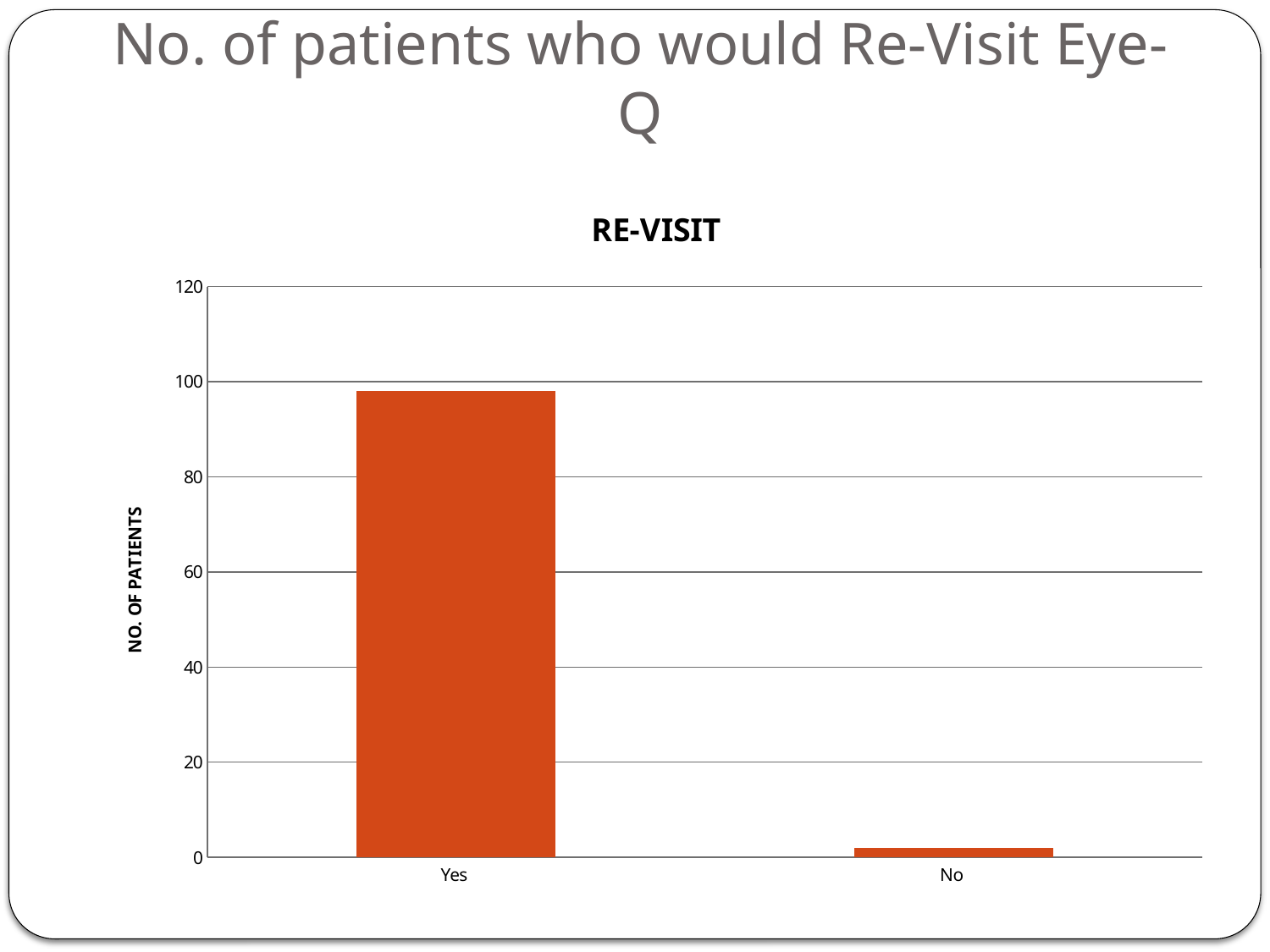
Is the value for Yes greater or less than 100? less What is the highest tick value shown on the vertical axis? 120 Is the value for Yes greater or less than 80? greater Which category has the lowest value in the chart? No How many categories are shown on the x axis of the chart? 2 Which category has the highest value in the chart? Yes Is the value for No greater or less than 20? less What kind of chart is shown on the slide? bar chart Do the values rise or fall from Yes to No along the x axis? fall What is the title of the chart? RE-VISIT Which is larger, the value for Yes or the value for No? Yes What is the label on the vertical axis of the chart? NO. OF PATIENTS